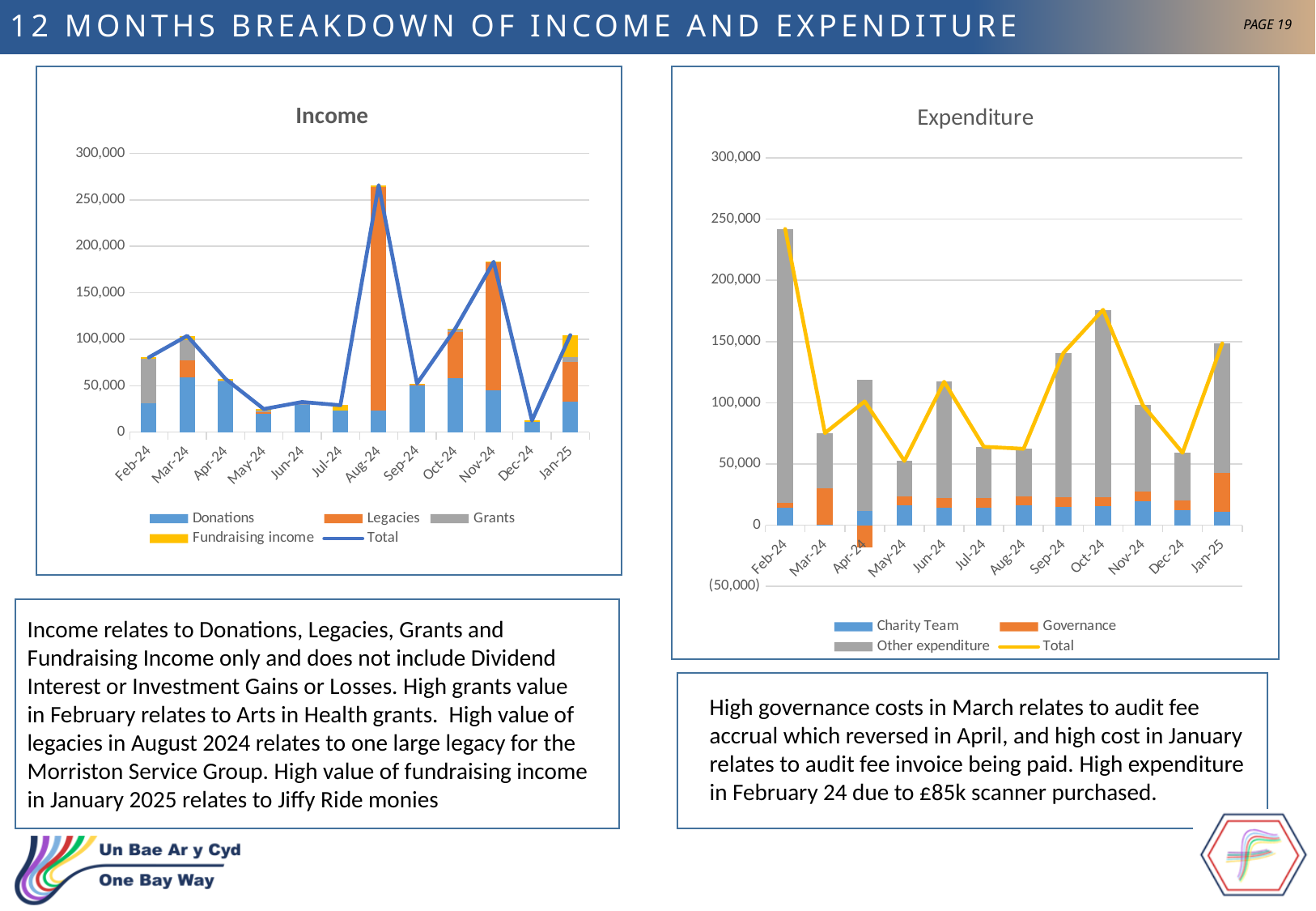
What type of chart is the Income chart? Bar chart with a line How many series does the legend of the Expenditure chart list? 4 How many series does the legend of the Income chart list? 5 In the Expenditure chart, which month has the highest Total? Feb-24 How many months are shown on the x axis of the Income chart? 12 In the Income chart, is the Total for Dec-24 greater or less than 50,000? less In the Expenditure chart, is the Governance value for Apr-24 greater or less than 0? less In the Income chart, which month has the highest Total? Aug-24 In the Income chart, which is larger, the Total for Aug-24 or the Total for Nov-24? Aug-24 In the Income chart, is the Total for Aug-24 greater or less than 250,000? greater In the Income chart, which month has the lowest Total? Dec-24